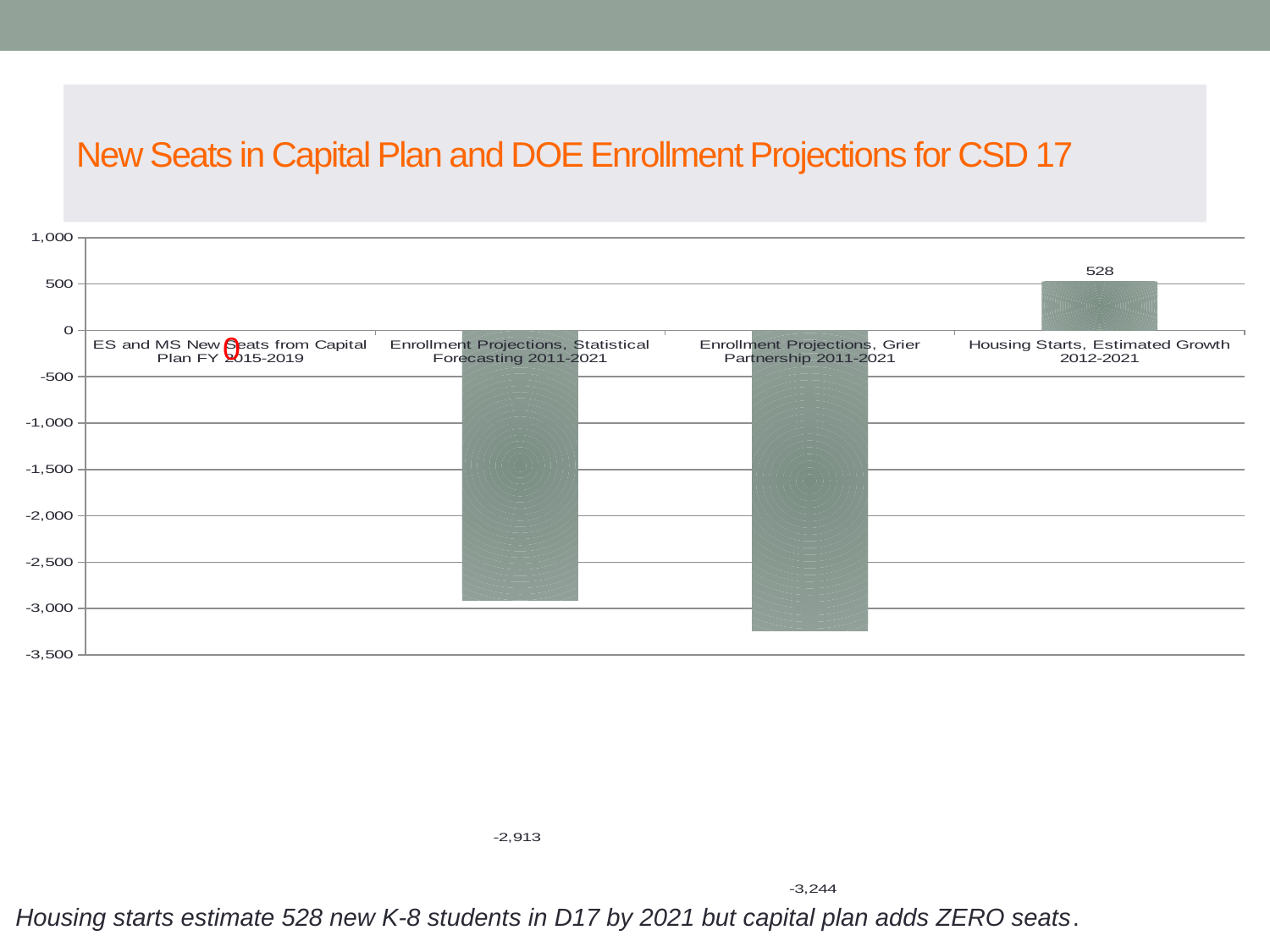
Is the value for Housing Starts, Estimated Growth 2012-2021 greater or less than 1,000? less Which category has the highest value? Housing Starts, Estimated Growth 2012-2021 What is the value for ES and MS New Seats from Capital Plan FY 2015-2019? 0 What is the value for Enrollment Projections, Statistical Forecasting 2011-2021? -2,913 How many categories are plotted in the chart? 4 What is the value for Housing Starts, Estimated Growth 2012-2021? 528 Which category has the lowest value? Enrollment Projections, Grier Partnership 2011-2021 Which is larger, the value for Enrollment Projections, Statistical Forecasting 2011-2021 or the value for Enrollment Projections, Grier Partnership 2011-2021? Enrollment Projections, Statistical Forecasting 2011-2021 What is the difference between the Statistical Forecasting projection (-2,913) and the Grier Partnership projection (-3,244)? 331 What type of chart is shown on the slide? bar chart What is the title of the chart? New Seats in Capital Plan and DOE Enrollment Projections for CSD 17 What is the value for Enrollment Projections, Grier Partnership 2011-2021? -3,244